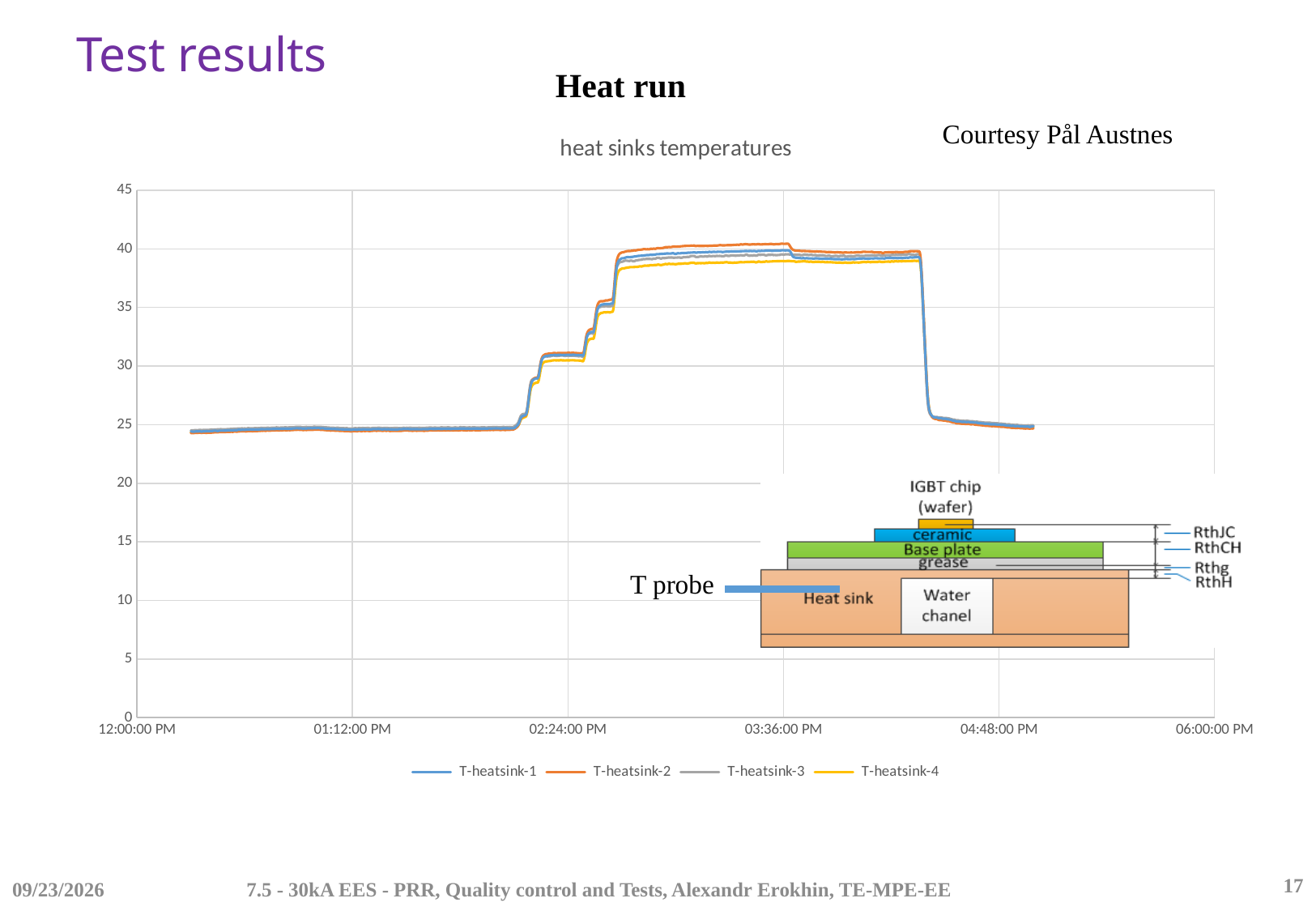
Which series has the lowest temperature during the plateau around 03:36:00 PM? T-heatsink-4 Is the value of T-heatsink-1 at 03:36:00 PM greater or less than 35? greater What kind of chart is shown on the slide? line chart Is the value of T-heatsink-3 at 03:36:00 PM greater or less than 45? less Is the value of T-heatsink-2 at 01:12:00 PM greater or less than 30? less Which series is drawn in orange in the heat sinks temperatures chart? T-heatsink-2 What is the title of the chart on the slide? heat sinks temperatures Is the value of T-heatsink-2 at 03:36:00 PM larger or smaller than its value at 01:12:00 PM? larger How many series does the legend of the heat sinks temperatures chart list? 4 Do the heat sink temperatures rise or fall between 02:24:00 PM and 03:36:00 PM? rise Which series has the highest temperature during the plateau around 03:36:00 PM? T-heatsink-2